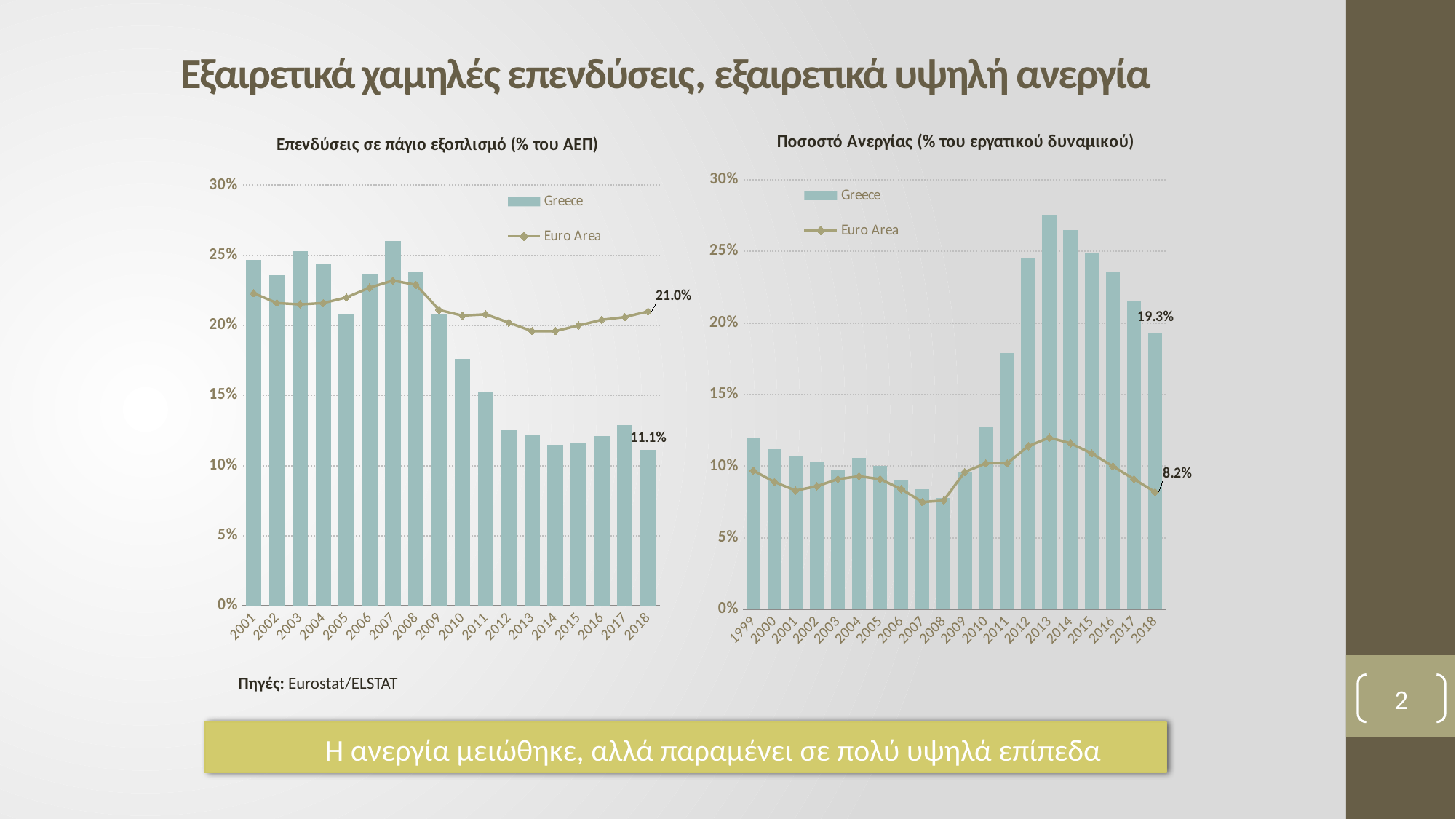
In the left chart (Επενδύσεις σε πάγιο εξοπλισμό), what is the Euro Area value in 2018? 21.0% In the left chart (Επενδύσεις σε πάγιο εξοπλισμό), in which year is the Greece bar highest? 2007 In the right chart (Ποσοστό Ανεργίας), how much higher is Greece's 2018 value than the Euro Area's 2018 value? 11.1 percentage points In the right chart (Ποσοστό Ανεργίας), what is the unemployment rate for Greece in 2018? 19.3% In the left chart (Επενδύσεις σε πάγιο εξοπλισμό), what is the value for Greece in 2018? 11.1% In the left chart (Επενδύσεις σε πάγιο εξοπλισμό), do the Greece bars rise or fall from 2007 to 2014? fall In the right chart (Ποσοστό Ανεργίας), in which year is the Greece bar highest? 2013 How many years are shown on the x axis of the right chart (Ποσοστό Ανεργίας)? 20 In the right chart (Ποσοστό Ανεργίας), what is the Euro Area unemployment rate in 2018? 8.2% In the left chart (Επενδύσεις σε πάγιο εξοπλισμό), what is the difference between the Euro Area and Greece values in 2018? 9.9 percentage points In the right chart (Ποσοστό Ανεργίας), is the Greece value for 2013 greater or less than 25%? greater How many series does the legend of the left chart (Επενδύσεις σε πάγιο εξοπλισμό) list? 2